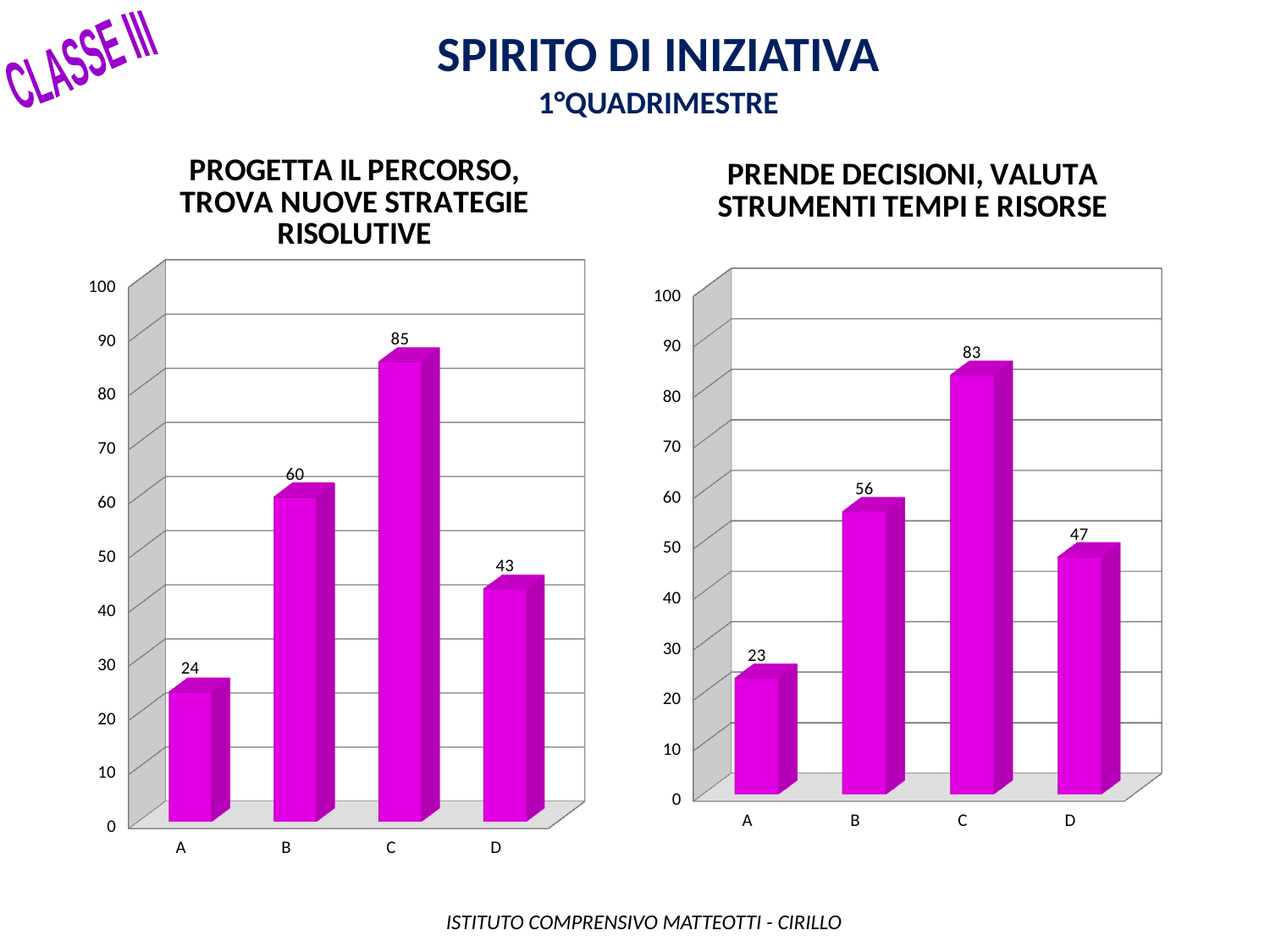
In the left chart (PROGETTA IL PERCORSO, TROVA NUOVE STRATEGIE RISOLUTIVE), is the value for D greater or less than 50? less In the left chart (PROGETTA IL PERCORSO, TROVA NUOVE STRATEGIE RISOLUTIVE), what is the difference between the values for C and B? 25 In the right chart (PRENDE DECISIONI, VALUTA STRUMENTI TEMPI E RISORSE), what is the value for category B? 56 What is the value for category A in the left chart (PROGETTA IL PERCORSO, TROVA NUOVE STRATEGIE RISOLUTIVE)? 24 What kind of chart is the left chart (PROGETTA IL PERCORSO, TROVA NUOVE STRATEGIE RISOLUTIVE)? Bar chart How many categories are shown in the right chart (PRENDE DECISIONI, VALUTA STRUMENTI TEMPI E RISORSE)? 4 In the left chart (PROGETTA IL PERCORSO, TROVA NUOVE STRATEGIE RISOLUTIVE), what is the value for category C? 85 In the right chart (PRENDE DECISIONI, VALUTA STRUMENTI TEMPI E RISORSE), which is larger, the value for B or the value for D? B In the left chart (PROGETTA IL PERCORSO, TROVA NUOVE STRATEGIE RISOLUTIVE), which category has the lowest value? A What is the title of the right chart? PRENDE DECISIONI, VALUTA STRUMENTI TEMPI E RISORSE In the right chart (PRENDE DECISIONI, VALUTA STRUMENTI TEMPI E RISORSE), what is the difference between the values for D and A? 24 In the right chart (PRENDE DECISIONI, VALUTA STRUMENTI TEMPI E RISORSE), which category has the highest value? C